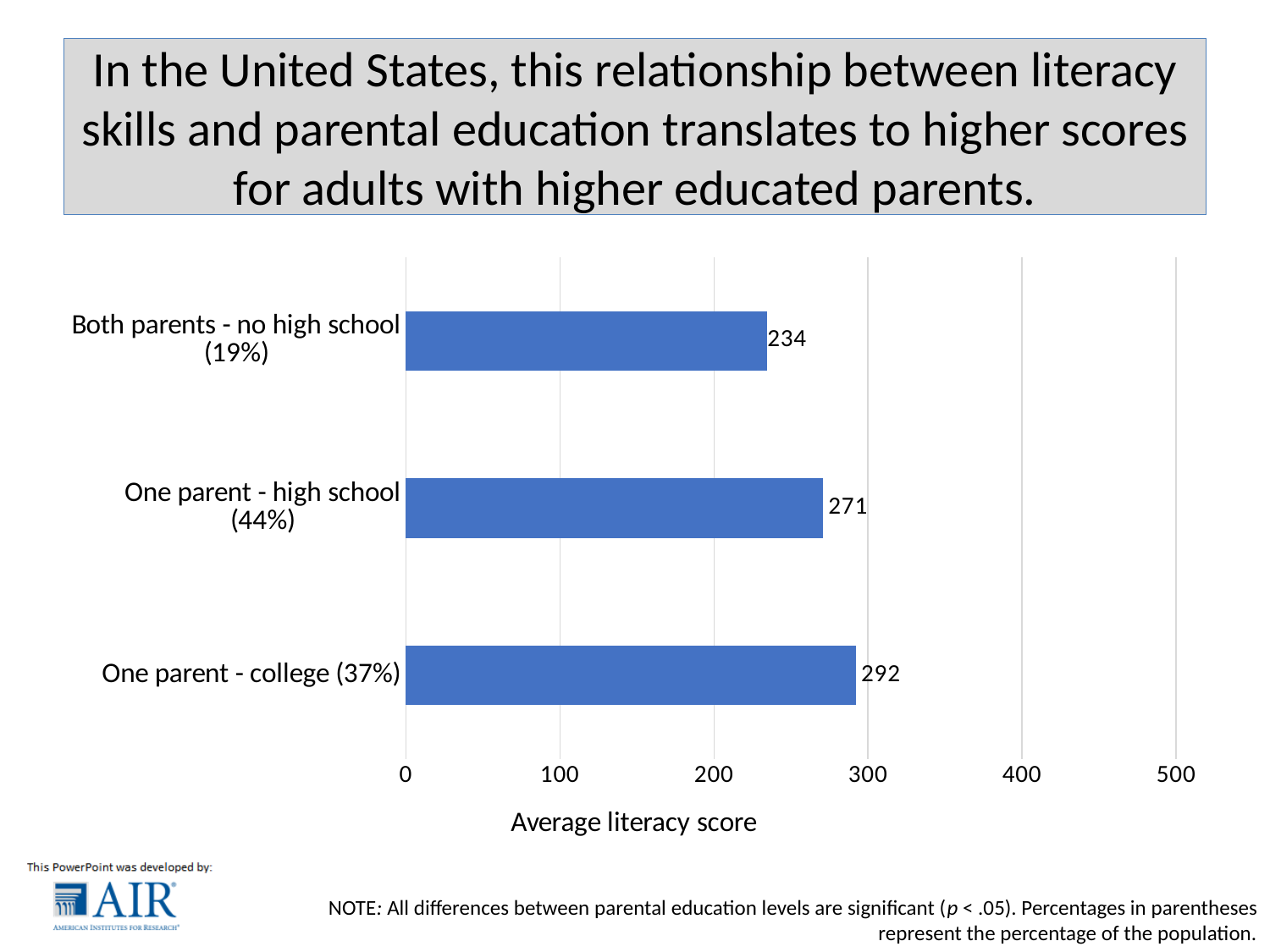
Is the average literacy score for 'One parent - high school' greater or less than 300? less What is the difference in average literacy score between 'One parent - college' and 'Both parents - no high school'? 58 What is the difference in average literacy score between 'One parent - college' and 'One parent - high school'? 21 What type of chart is shown on the slide? Bar chart What is the average literacy score for the 'One parent - high school (44%)' category? 271 Which parental education category has the lowest average literacy score? Both parents - no high school (19%) How many parental education categories are shown in the chart? 3 What is the average literacy score for the 'One parent - college (37%)' category? 292 What is the average literacy score for adults with both parents having no high school education? 234 Which parental education category has the highest average literacy score? One parent - college (37%) Which has a higher average literacy score: 'One parent - high school' or 'Both parents - no high school'? One parent - high school What is the label of the horizontal axis of the chart? Average literacy score